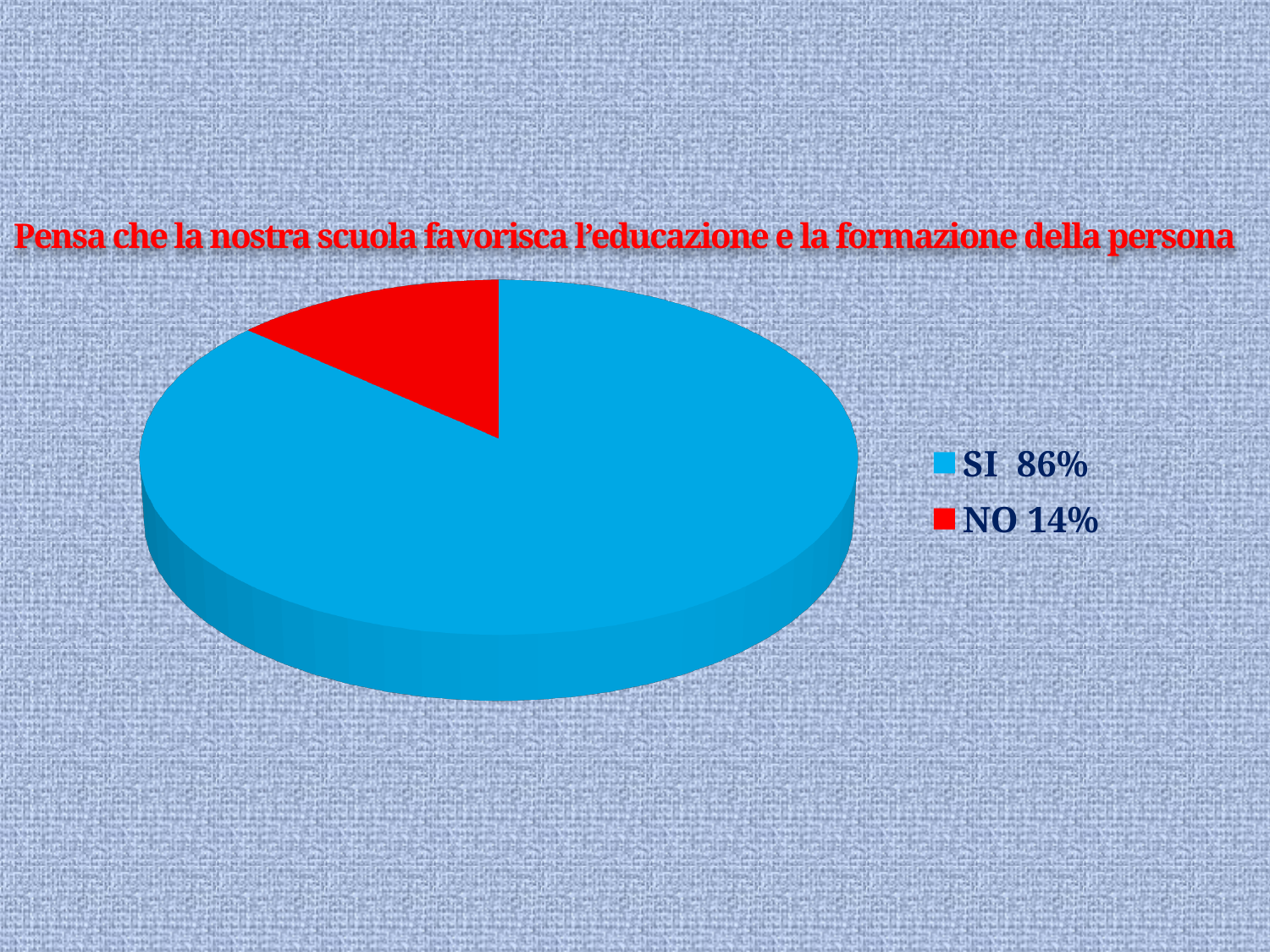
What is the title of the chart? Pensa che la nostra scuola favorisca l'educazione e la formazione della persona What kind of chart is shown on the slide? pie chart How many categories does the pie chart have? 2 Which category has the largest share of the pie? SI What percentage is shown for SI? 86% What is the difference in percentage points between SI and NO? 72 Which category has the smallest share of the pie? NO What colour is the slice for NO? red How many entries does the legend list? 2 Which is larger, the share for SI or the share for NO? SI What percentage is shown for NO? 14% What share of the pie does the SI slice represent? 86%